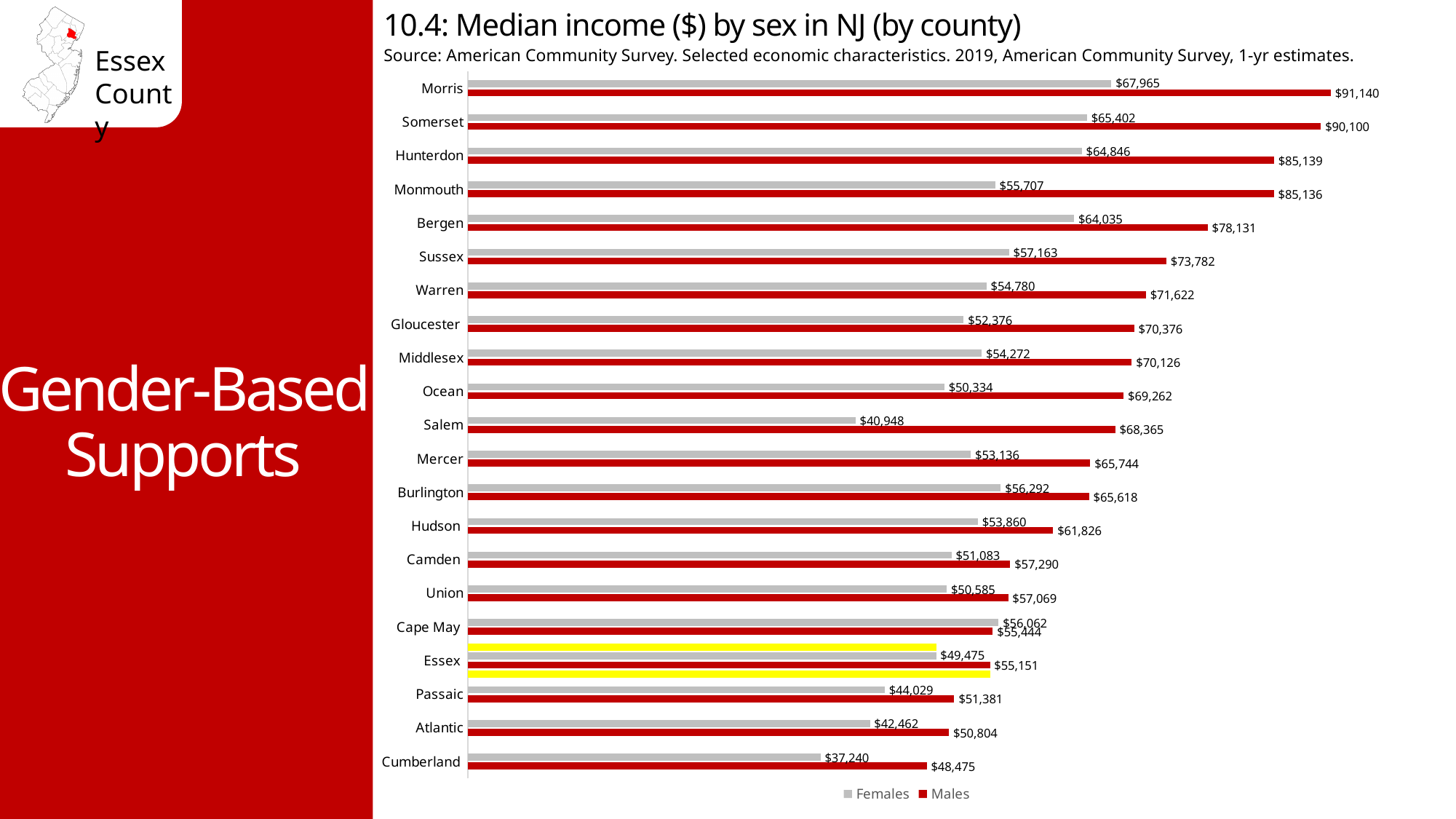
What type of chart is shown on the slide? Bar chart How many series does the legend list? 2 What is the median income for females in Essex County? $49,475 Which county has the highest median income for females? Morris What is the median income for females in Salem County? $40,948 In Cape May County, which is higher: the median income for females or for males? Females Which county has the lowest median income for males? Cumberland How many counties are shown in the chart? 21 Which county has a higher median income for males: Hudson or Burlington? Burlington What is the difference between male and female median income in Essex County? $5,676 What is the median income for males in Morris County? $91,140 What is the difference between male and female median income in Monmouth County? $29,429